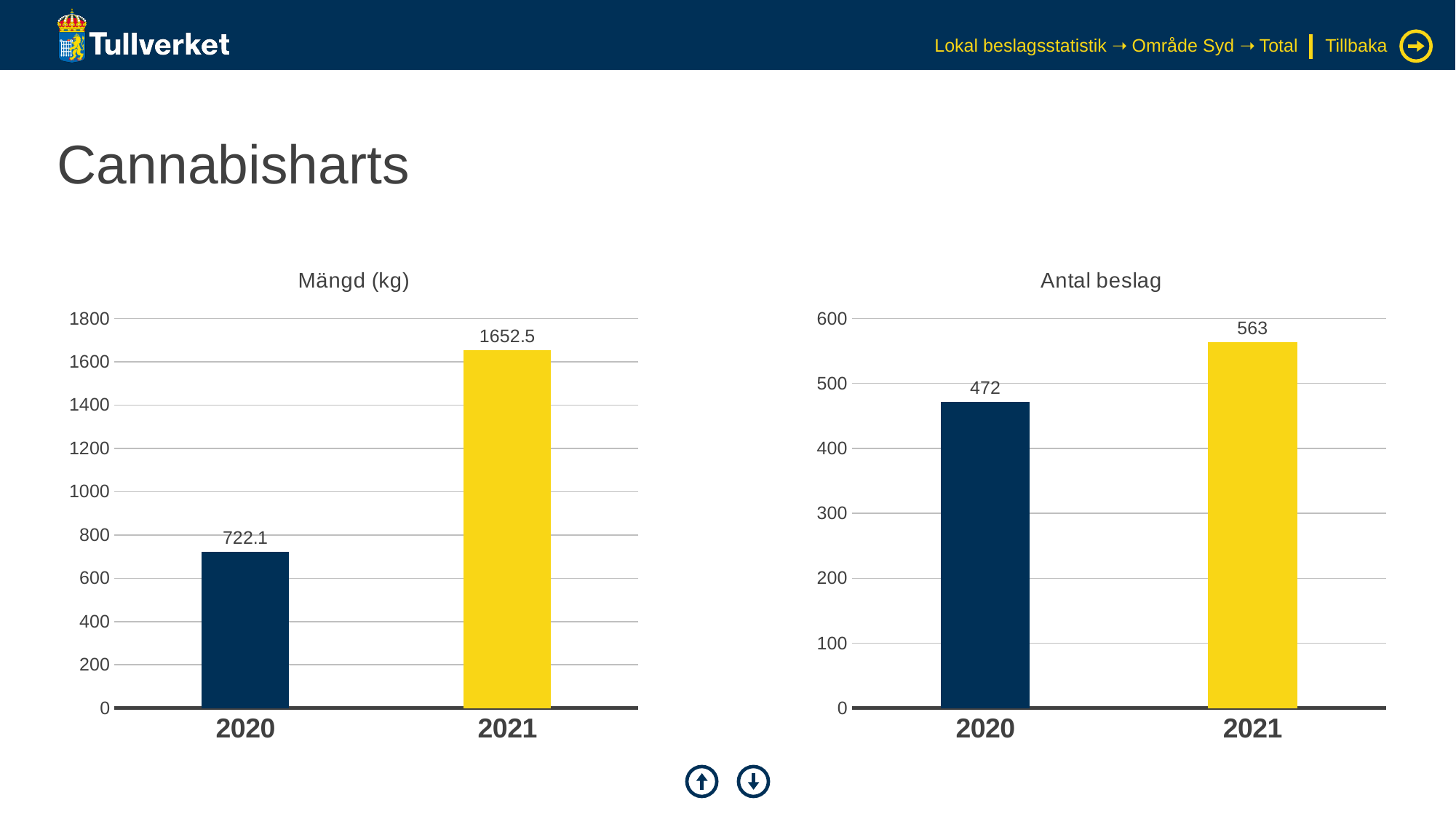
In the 'Mängd (kg)' chart, what is the value for 2020? 722.1 In the 'Antal beslag' chart, which year has the lowest value? 2020 In the 'Antal beslag' chart, what is the value for 2020? 472 What kind of chart is the 'Antal beslag' chart? bar chart In the 'Mängd (kg)' chart, do the values rise or fall from 2020 to 2021? rise In the 'Antal beslag' chart, what is the value for 2021? 563 In the 'Mängd (kg)' chart, what is the difference between the 2021 and 2020 values? 930.4 In the 'Mängd (kg)' chart, what is the value for 2021? 1652.5 In the 'Mängd (kg)' chart, which year has the highest value? 2021 In the 'Antal beslag' chart, is the value for 2020 greater or less than 500? less How many categories are shown in the 'Mängd (kg)' chart? 2 In the 'Antal beslag' chart, what is the difference between the 2021 and 2020 values? 91